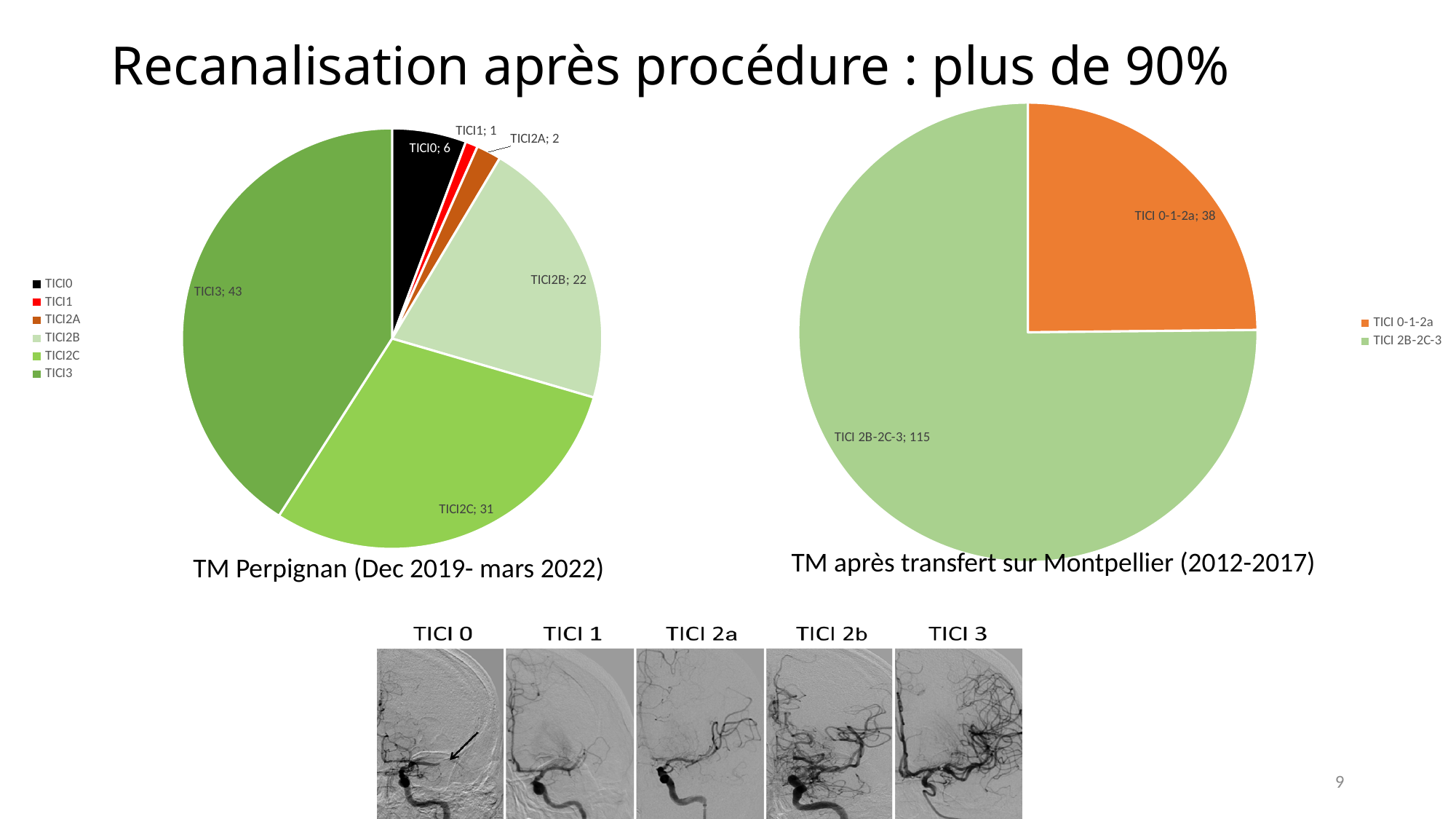
In the TM Perpignan (Dec 2019- mars 2022) chart, what is the value for TICI2B? 22 In the TM Perpignan (Dec 2019- mars 2022) chart, which category has the largest slice? TICI3 What kind of chart is the TM après transfert sur Montpellier (2012-2017) chart? Pie chart In the TM Perpignan (Dec 2019- mars 2022) chart, which category has the smallest slice? TICI1 In the TM après transfert sur Montpellier (2012-2017) chart, what is the difference between the TICI 2B-2C-3 and TICI 0-1-2a values? 77 In the TM après transfert sur Montpellier (2012-2017) chart, what is the value for TICI 2B-2C-3? 115 How many categories does the TM Perpignan (Dec 2019- mars 2022) chart show? 6 In the TM Perpignan (Dec 2019- mars 2022) chart, what is the difference between the TICI3 and TICI2C values? 12 In the TM Perpignan (Dec 2019- mars 2022) chart, what is the value for TICI3? 43 In the TM après transfert sur Montpellier (2012-2017) chart, what is the value for TICI 0-1-2a? 38 In the TM Perpignan (Dec 2019- mars 2022) chart, which is larger, TICI2B or TICI2C? TICI2C In the TM après transfert sur Montpellier (2012-2017) chart, what colour is the TICI 0-1-2a slice? Orange